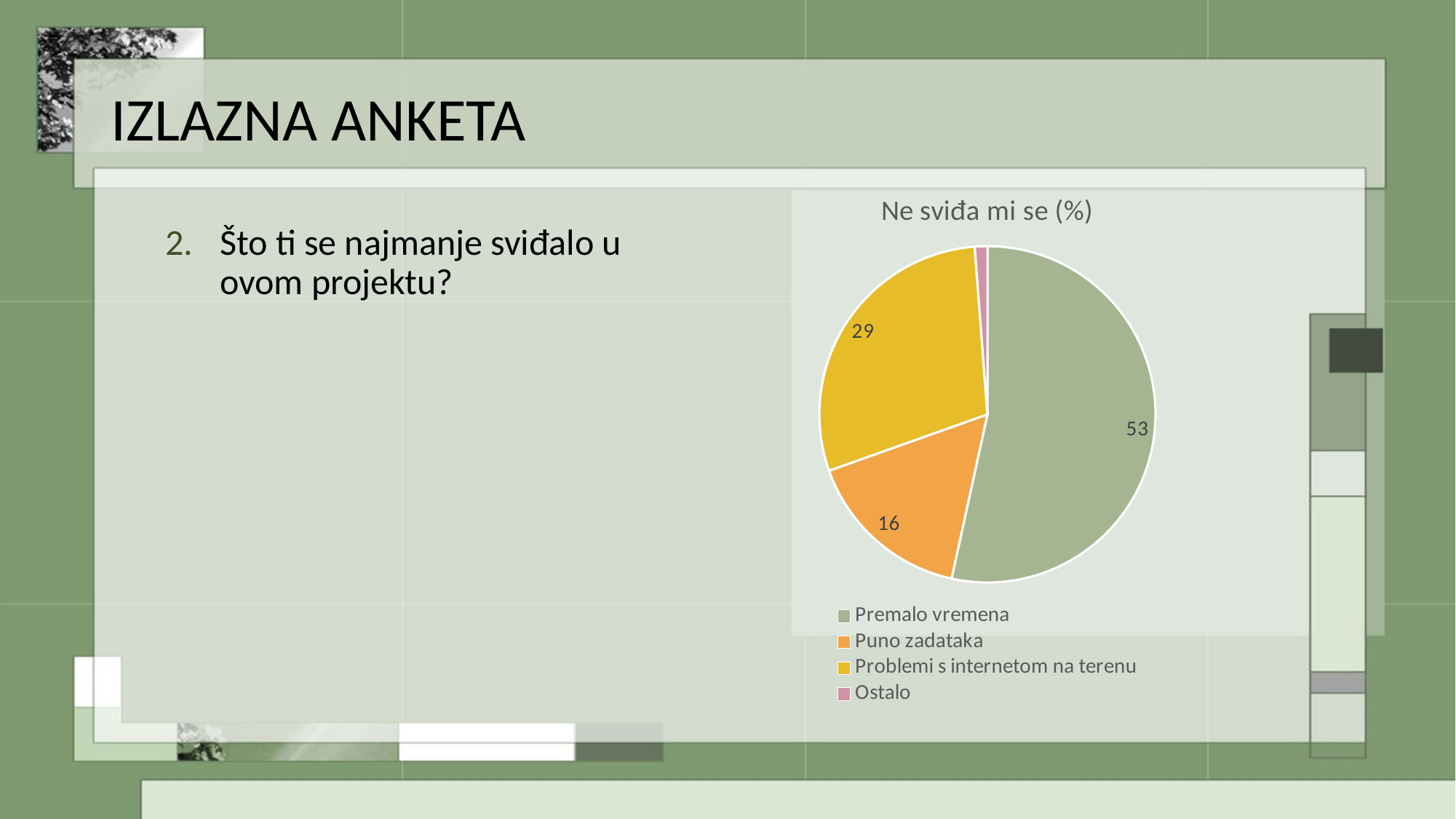
What is the difference between the values for Premalo vremena and Problemi s internetom na terenu? 24 What is the title of the chart? Ne sviđa mi se (%) What is the value shown for Problemi s internetom na terenu in the pie chart? 29 What is the value shown for Premalo vremena in the pie chart? 53 Which colour represents Ostalo in the pie chart? Pink Which is larger, the slice for Puno zadataka or the slice for Problemi s internetom na terenu? Problemi s internetom na terenu Which category has the smallest slice in the pie chart? Ostalo What is the value shown for Puno zadataka in the pie chart? 16 Which category has the largest slice in the pie chart? Premalo vremena What is the difference between the values for Problemi s internetom na terenu and Puno zadataka? 13 What kind of chart is shown on the slide? Pie chart How many categories does the pie chart show? 4